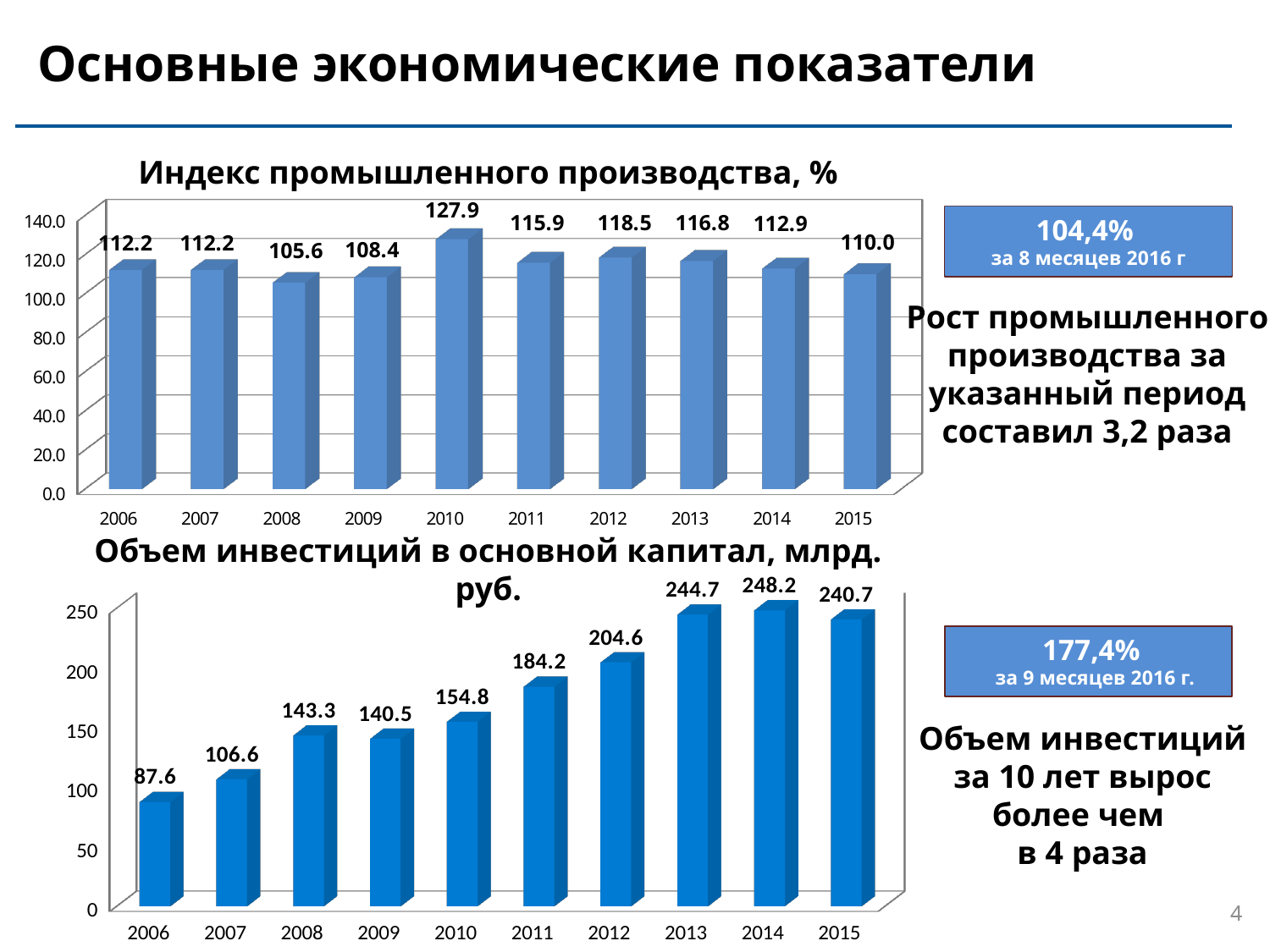
In the chart 'Объем инвестиций в основной капитал, млрд. руб.', what is the difference between the values for 2015 and 2006? 153.1 In the chart 'Объем инвестиций в основной капитал, млрд. руб.', which year has the highest value? 2014 In the chart 'Объем инвестиций в основной капитал, млрд. руб.', what is the value for 2006? 87.6 In the chart 'Индекс промышленного производства, %', what is the value for 2010? 127.9 In the chart 'Объем инвестиций в основной капитал, млрд. руб.', is the value for 2012 greater or less than 200? greater In the chart 'Индекс промышленного производства, %', how many years are shown on the x axis? 10 In the chart 'Индекс промышленного производства, %', which year has the highest value? 2010 What kind of chart is the bottom chart 'Объем инвестиций в основной капитал, млрд. руб.'? bar chart In the chart 'Объем инвестиций в основной капитал, млрд. руб.', which is larger, the value for 2008 or the value for 2009? 2008 In the chart 'Индекс промышленного производства, %', what is the difference between the values for 2010 and 2015? 17.9 In the chart 'Индекс промышленного производства, %', which year has the lowest value? 2008 In the chart 'Объем инвестиций в основной капитал, млрд. руб.', do the values generally rise or fall from 2006 to 2014? rise